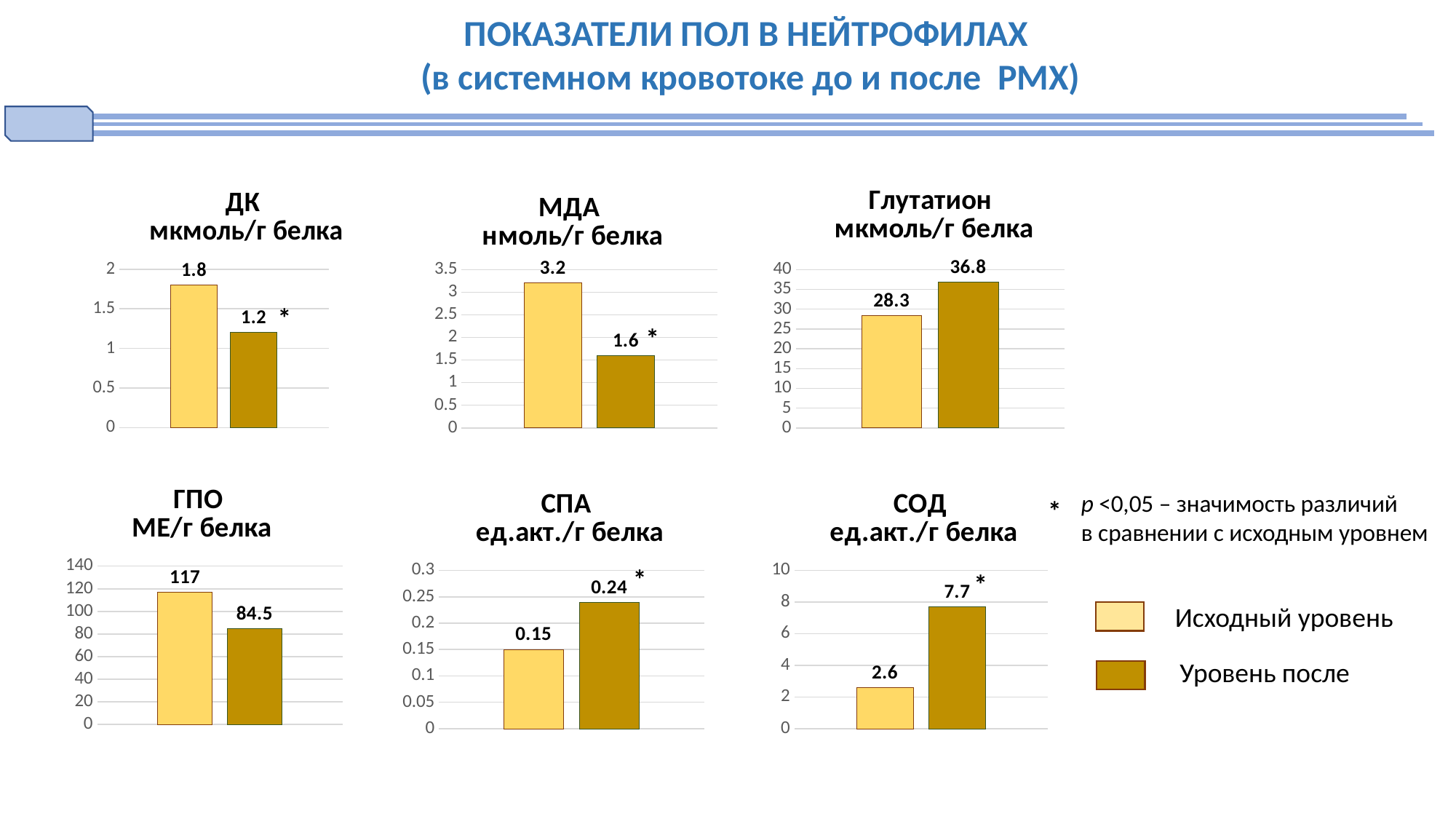
In the МДА chart, what is the difference between the Исходный уровень value and the Уровень после value? 1.6 What kind of chart is the МДА chart? Bar chart In the ДК chart, what is the value for Уровень после? 1.2 How many series does the legend on the slide list? 2 In the Глутатион chart, what is the value for Уровень после? 36.8 In the ГПО chart, what is the value for Исходный уровень? 117 In the СОД chart, what is the value for Исходный уровень? 2.6 In the СОД chart, which bar is the highest? Уровень после In the ГПО chart, what is the difference between the Исходный уровень value and the Уровень после value? 32.5 In the ДК chart, what is the value for Исходный уровень? 1.8 In the СПА chart, what is the value for Уровень после? 0.24 In the Глутатион chart, which is larger: Исходный уровень or Уровень после? Уровень после